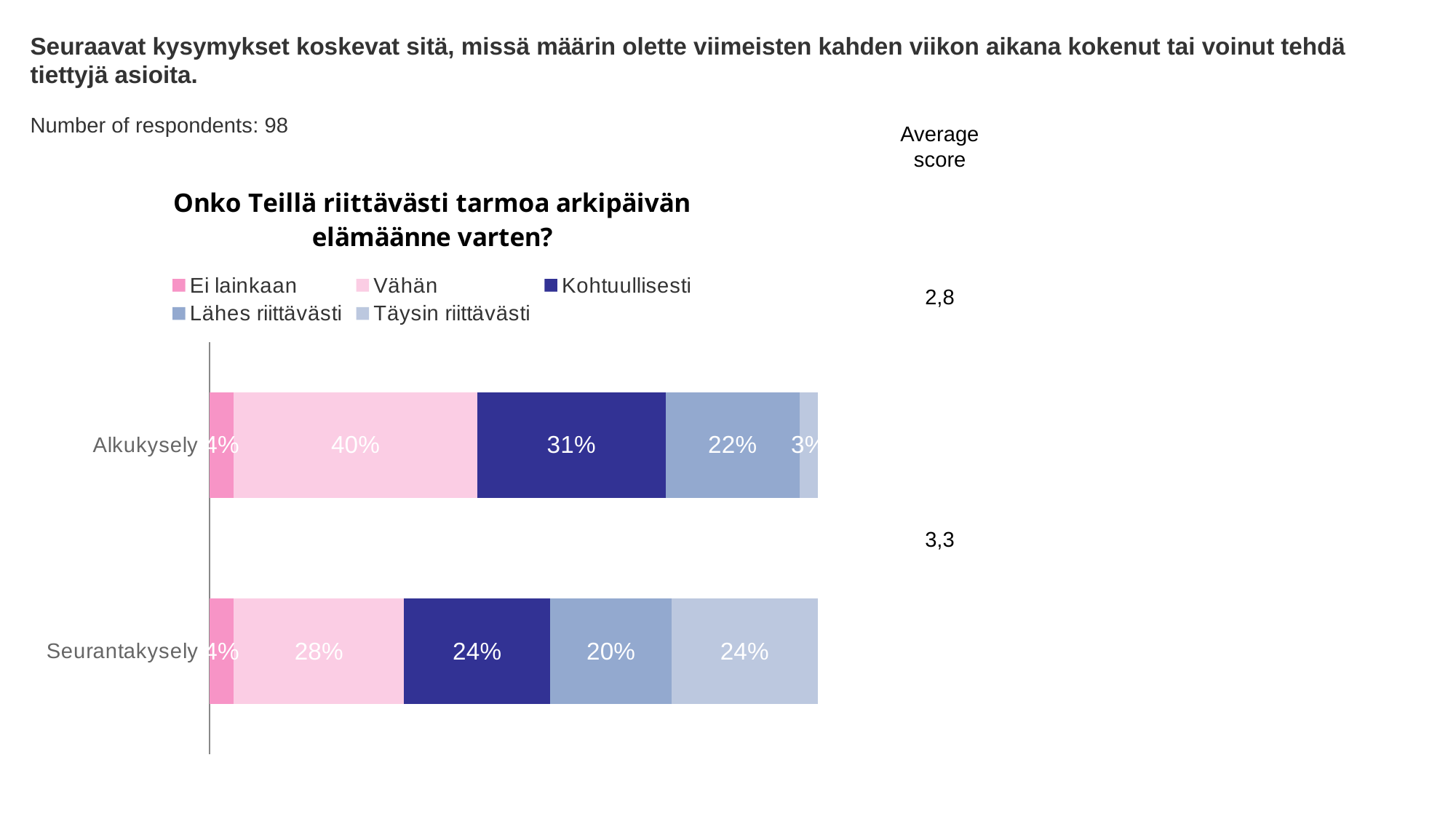
What percentage of Alkukysely respondents answered "Kohtuullisesti"? 31% How many categories (survey rounds) are shown on the chart? 2 What is the title of the chart? Onko Teillä riittävästi tarmoa arkipäivän elämäänne varten? What percentage of Seurantakysely respondents answered "Täysin riittävästi"? 24% What percentage of Alkukysely respondents answered "Vähän"? 40% How many series does the legend list? 5 What kind of chart is shown on the slide? Stacked bar chart Which response option has the smallest share in the Alkukysely bar? Täysin riittävästi What percentage of Seurantakysely respondents answered "Lähes riittävästi"? 20% Is the "Täysin riittävästi" share larger in Alkukysely or in Seurantakysely? Seurantakysely What is the difference between the "Vähän" share in Alkukysely and in Seurantakysely? 12 percentage points Which response option has the largest share in the Alkukysely bar? Vähän